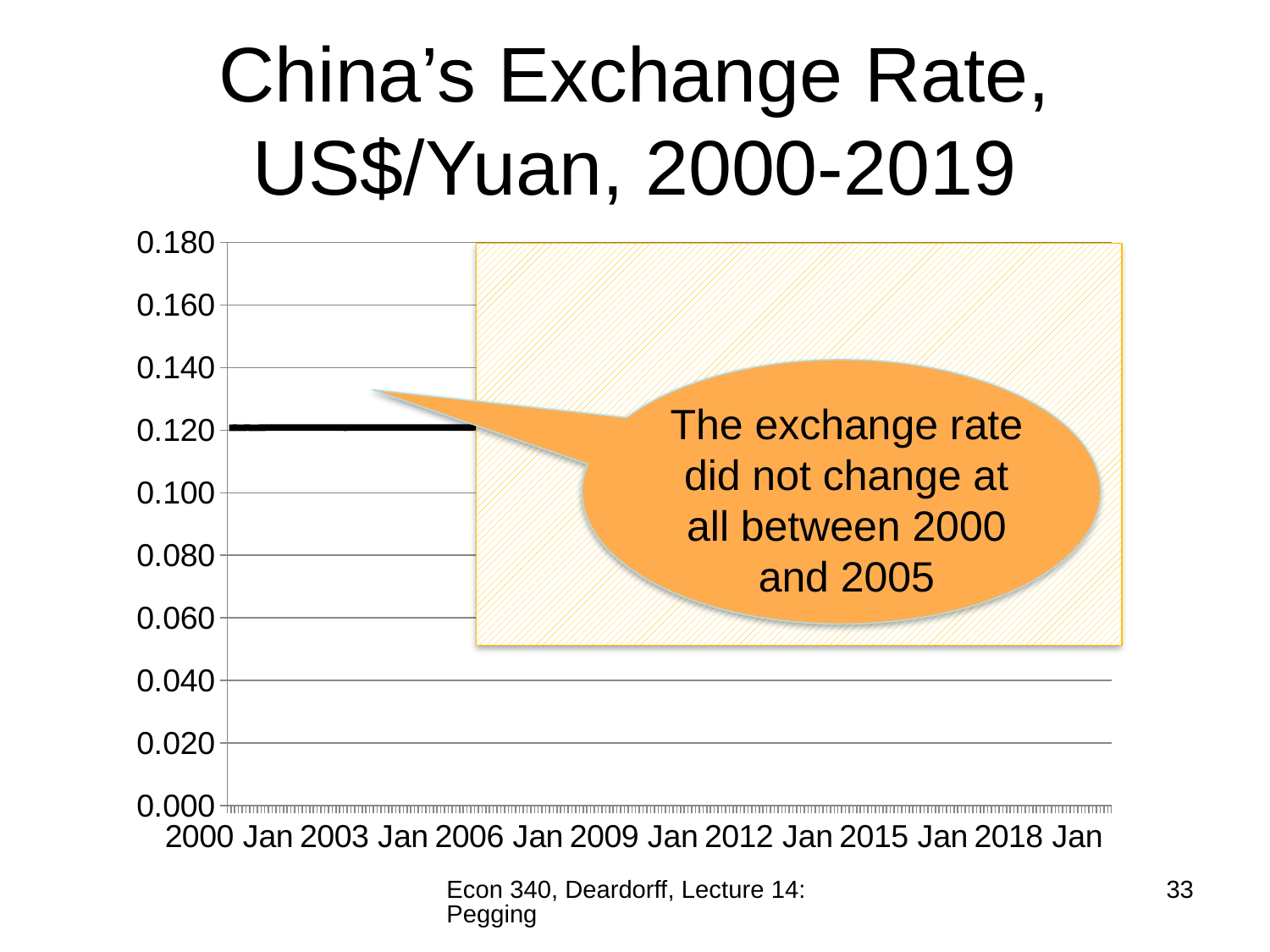
What is the first year label on the x axis? 2000 Jan Is the exchange rate in 2003 Jan greater or less than 0.140? less What is the highest value shown on the y axis? 0.180 What is the last year label on the x axis? 2018 Jan Is the exchange rate in 2003 Jan greater or less than 0.100? greater What kind of chart is shown on the slide? line chart Is the exchange rate in 2000 Jan greater or less than 0.080? greater Did the exchange rate rise, fall, or stay flat between 2000 and 2005? stay flat What is the title of the chart? China's Exchange Rate, US$/Yuan, 2000-2019 How many year labels are shown on the x axis? 7 What does the callout on the chart say? The exchange rate did not change at all between 2000 and 2005